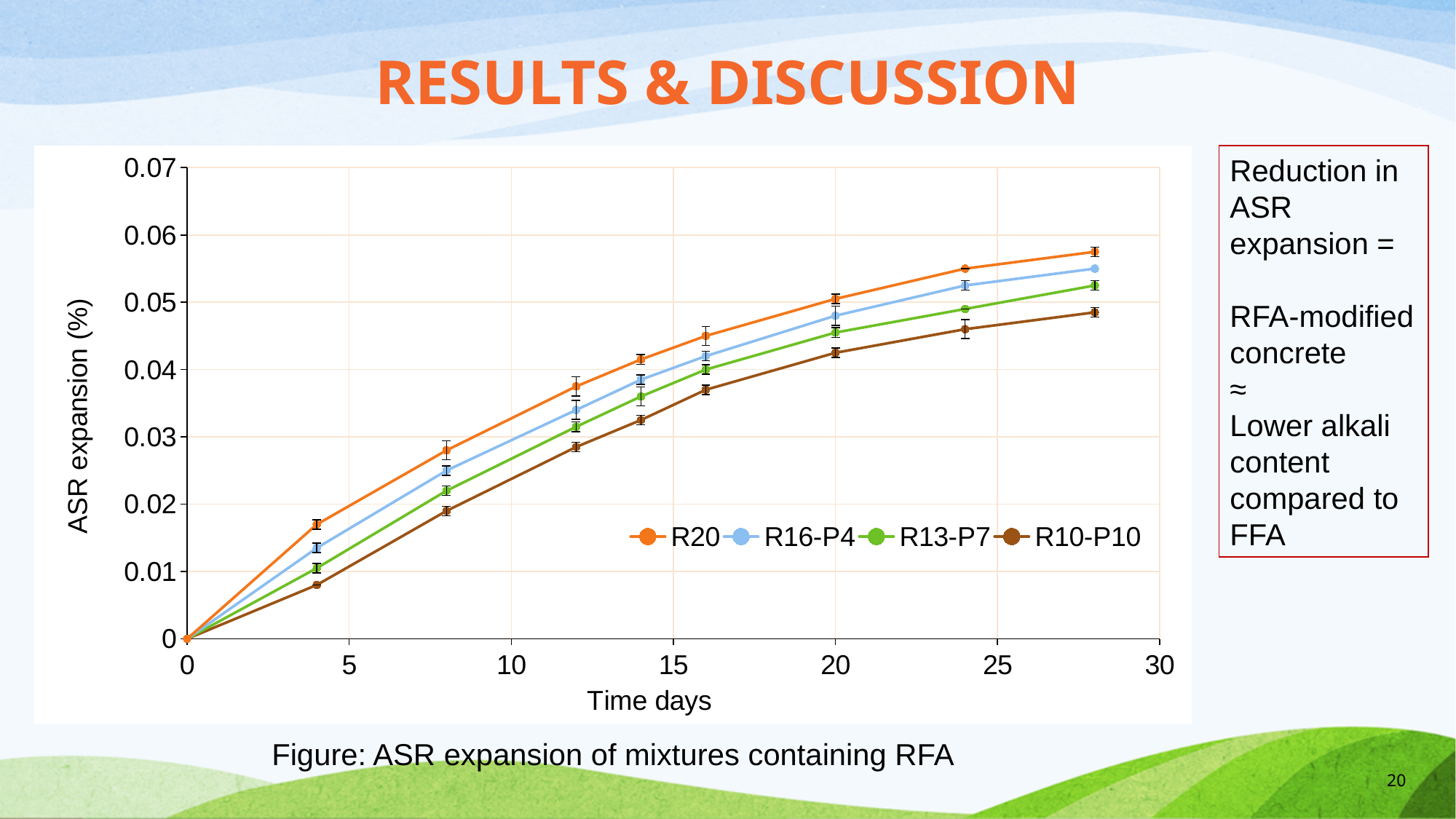
Which series has the highest ASR expansion at 28 days? R20 At 28 days, which series has the larger ASR expansion, R16-P4 or R13-P7? R16-P4 What kind of chart is shown on the slide? line chart What is the title of the x axis of the chart? Time days How many series does the chart legend list? 4 Is the ASR expansion for R20 at 4 days greater or less than 0.02? less Is the ASR expansion for R20 at 28 days greater or less than 0.05? greater Is the ASR expansion for R16-P4 at 16 days greater or less than 0.04? greater Do the ASR expansion values rise or fall as time increases? rise What is the ASR expansion of all four series at 0 days? 0 Which series has the lowest ASR expansion at 28 days? R10-P10